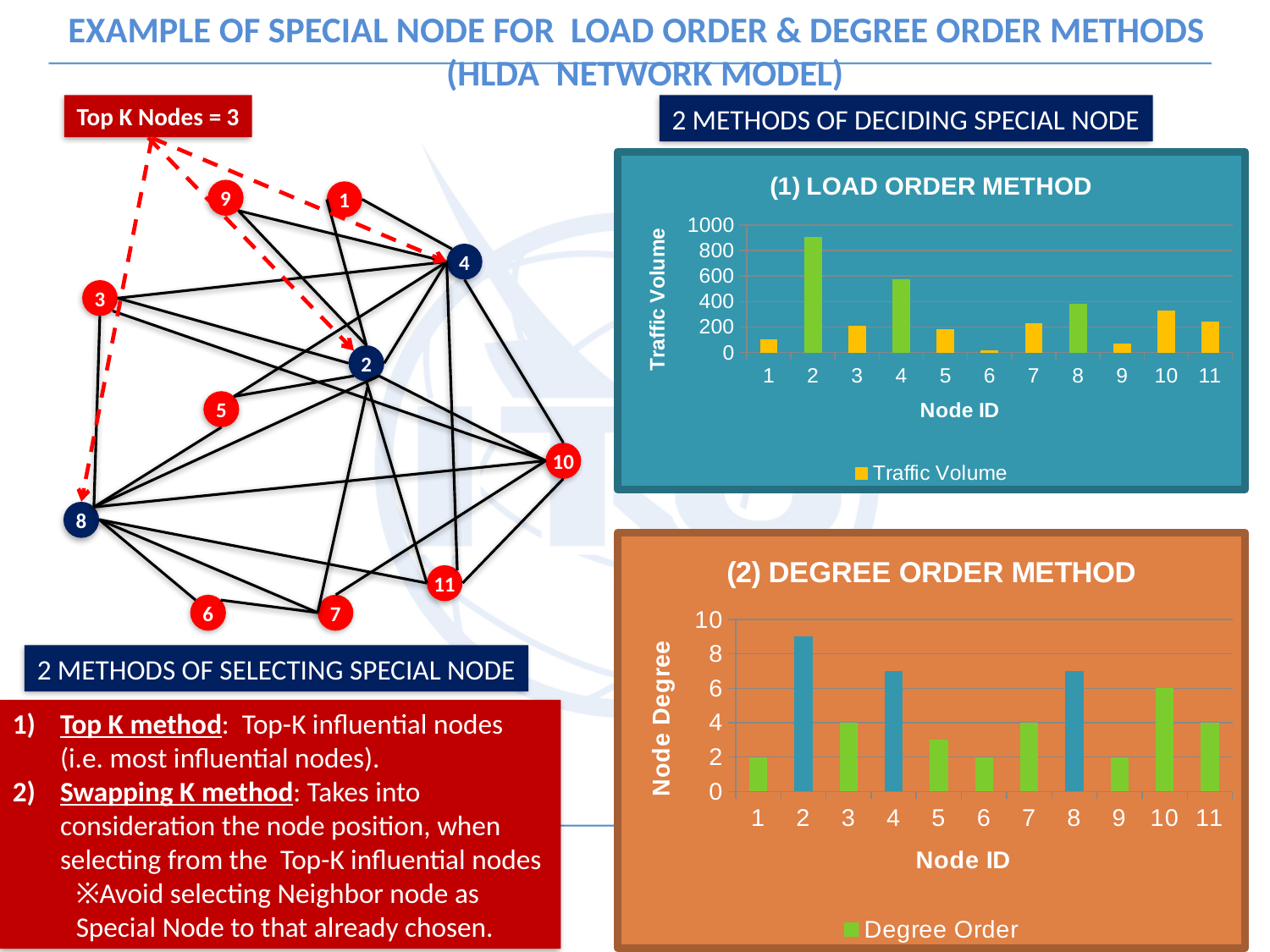
In the (1) LOAD ORDER METHOD chart, which has the larger traffic volume, Node ID 4 or Node ID 8? Node ID 4 In the (2) DEGREE ORDER METHOD chart, which Node ID has the highest node degree? 2 What is the legend entry shown below the (1) LOAD ORDER METHOD chart? Traffic Volume In the (1) LOAD ORDER METHOD chart, is the traffic volume for Node ID 6 greater or less than 200? less What kind of chart is the (2) DEGREE ORDER METHOD chart? bar chart In the (1) LOAD ORDER METHOD chart, is the traffic volume for Node ID 4 greater or less than 400? greater In the (2) DEGREE ORDER METHOD chart, what is the node degree for Node ID 3? 4 In the (2) DEGREE ORDER METHOD chart, what is the node degree for Node ID 10? 6 In the (1) LOAD ORDER METHOD chart, is the traffic volume for Node ID 2 greater or less than 800? greater How many Node IDs are shown on the x axis of the (1) LOAD ORDER METHOD chart? 11 In the (1) LOAD ORDER METHOD chart, which Node ID has the lowest traffic volume? 6 In the (1) LOAD ORDER METHOD chart, which Node ID has the highest traffic volume? 2